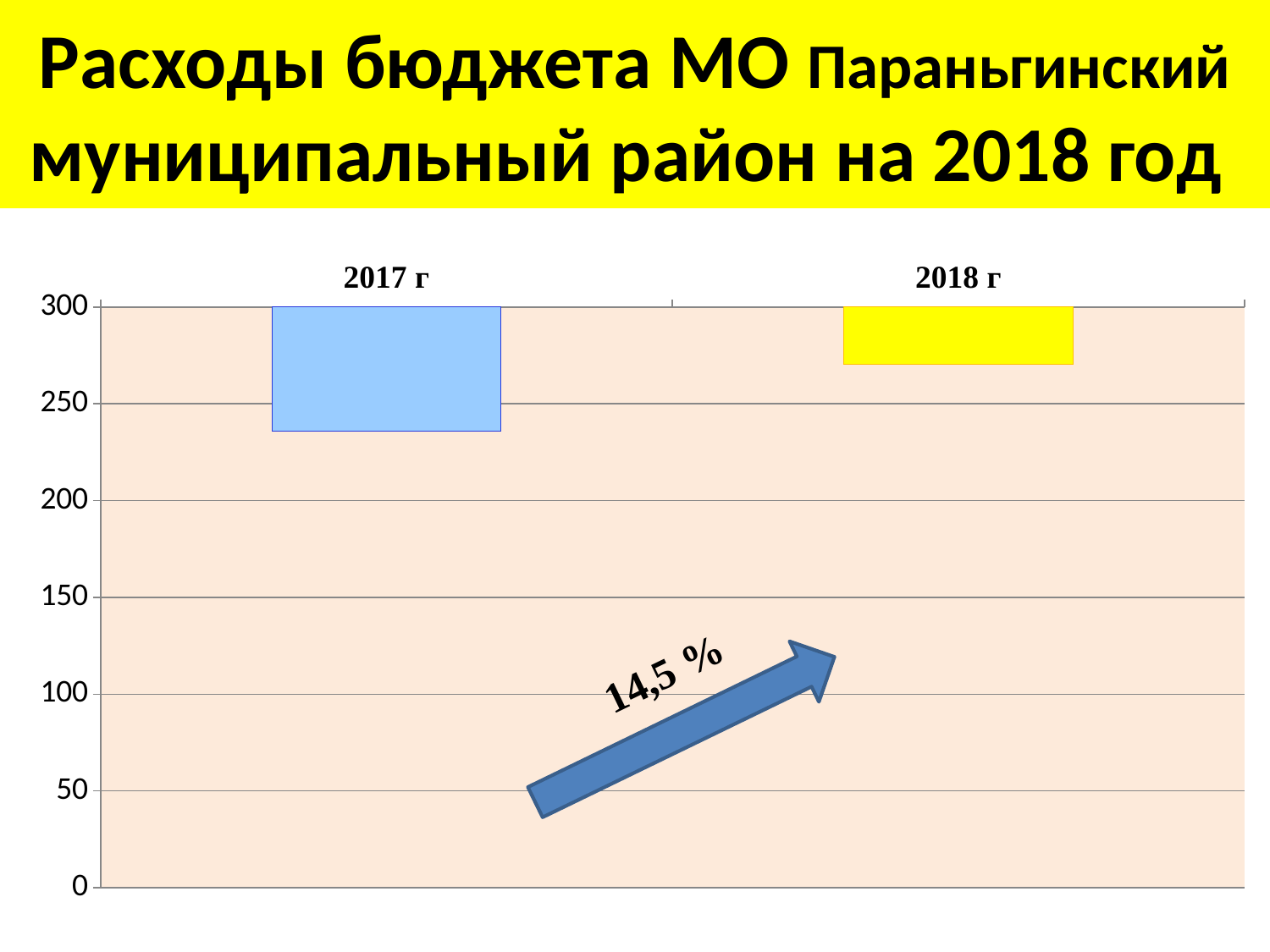
What kind of chart is shown on the slide? bar chart What colour is the bar for 2017 г? light blue What colour is the bar for 2018 г? yellow Is the lower edge of the 2017 г bar greater or less than 250 on the axis? less What percentage is written next to the arrow in the chart? 14,5 % Is the lower edge of the 2018 г bar greater or less than 250 on the axis? greater How many categories (years) are shown in the chart? 2